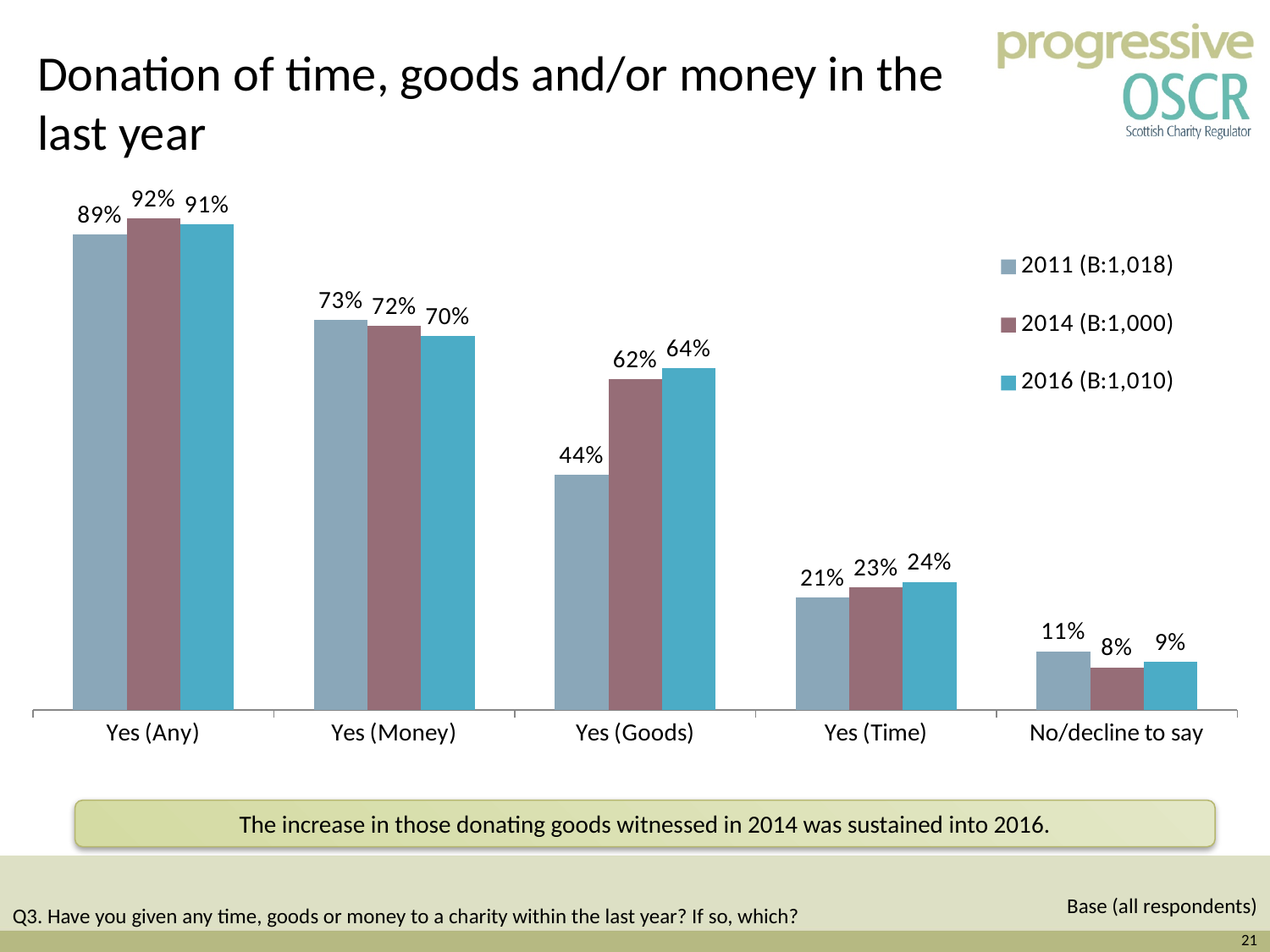
What is the value for Yes (Goods) in the 2011 (B:1,018) series? 44% What is the value for Yes (Time) in the 2016 (B:1,010) series? 24% How many series does the legend list? 3 What is the title of the chart? Donation of time, goods and/or money in the last year Which is larger for Yes (Money): the 2011 value or the 2016 value? 2011 What kind of chart is shown on the slide? Bar chart Which category has the lowest value in the 2016 (B:1,010) series? No/decline to say What is the difference between the 2016 and 2011 values for Yes (Goods)? 20 percentage points What is the value for No/decline to say in the 2014 (B:1,000) series? 8% How many categories are shown on the x axis? 5 Do the values for Yes (Goods) rise or fall from 2011 to 2016? Rise Which category has the highest value in the 2014 (B:1,000) series? Yes (Any)